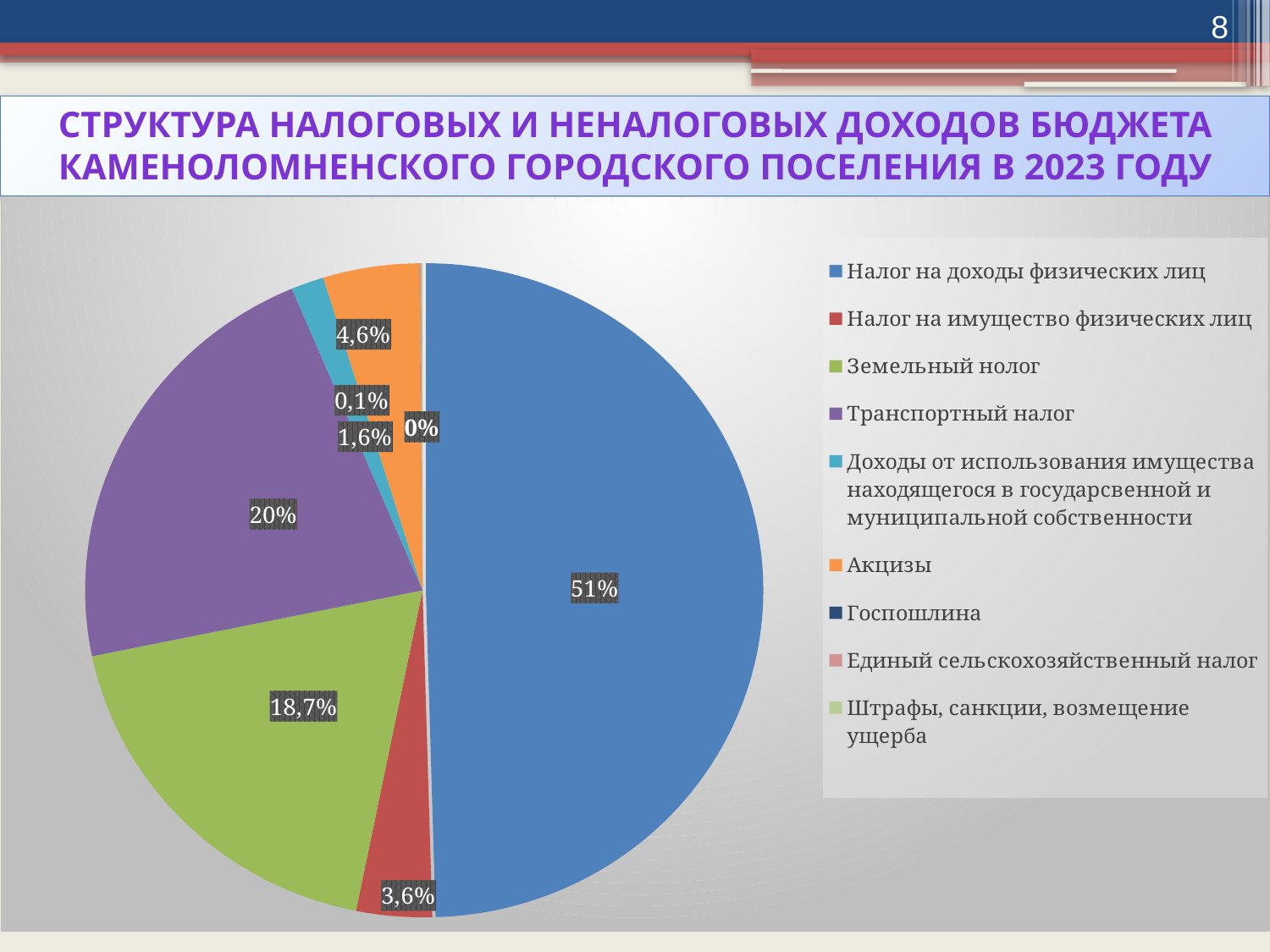
What is the value shown for "Налог на имущество физических лиц"? 3,6% What is the difference between the shares of "Транспортный налог" and "Земельный нолог"? 1,3% What share of the pie does "Налог на доходы физических лиц" have? 51% What colour is the slice for "Налог на доходы физических лиц"? blue What is the value shown for "Транспортный налог"? 20% What is the value shown for "Земельный нолог"? 18,7% What is the value shown for "Акцизы"? 4,6% What kind of chart is shown on the slide? pie chart Which category has the largest share of the pie? Налог на доходы физических лиц Which is larger, the share for "Транспортный налог" or for "Земельный нолог"? Транспортный налог What is the value shown for "Доходы от использования имущества находящегося в государсвенной и муниципальной собственности"? 1,6% How many categories does the legend list? 9